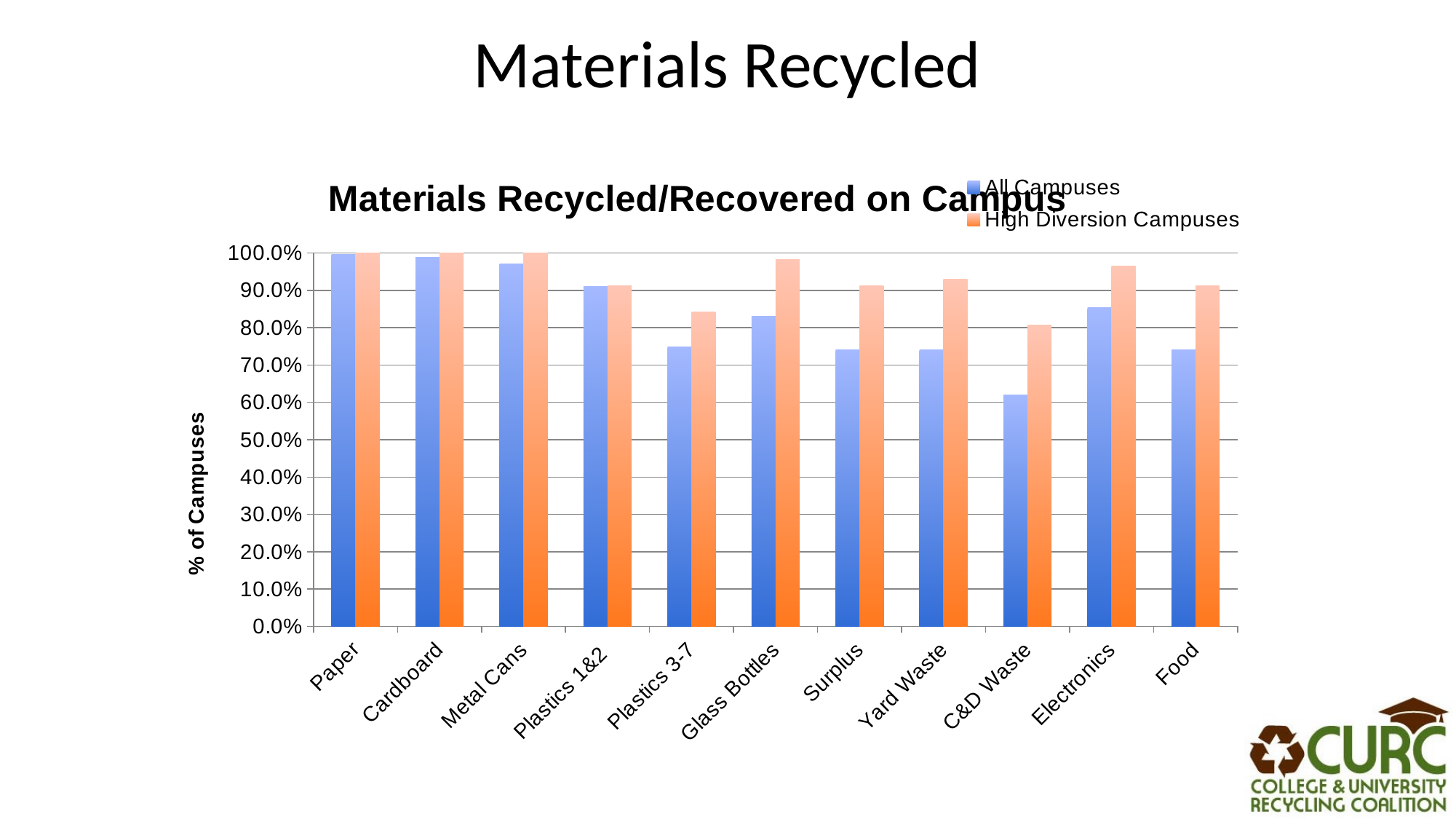
Is the High Diversion Campuses value for Glass Bottles greater or less than 90.0%? greater Is the All Campuses value for C&D Waste greater or less than 70.0%? less Is the All Campuses value for Plastics 3-7 greater or less than 80.0%? less What is the title of the y axis? % of Campuses For All Campuses, which is larger: Electronics or Food? Electronics Which category has the lowest value for All Campuses? C&D Waste How many material categories are shown on the x axis? 11 For High Diversion Campuses, which is larger: Glass Bottles or Surplus? Glass Bottles How many series does the legend list? 2 What kind of chart is shown on the slide? bar chart